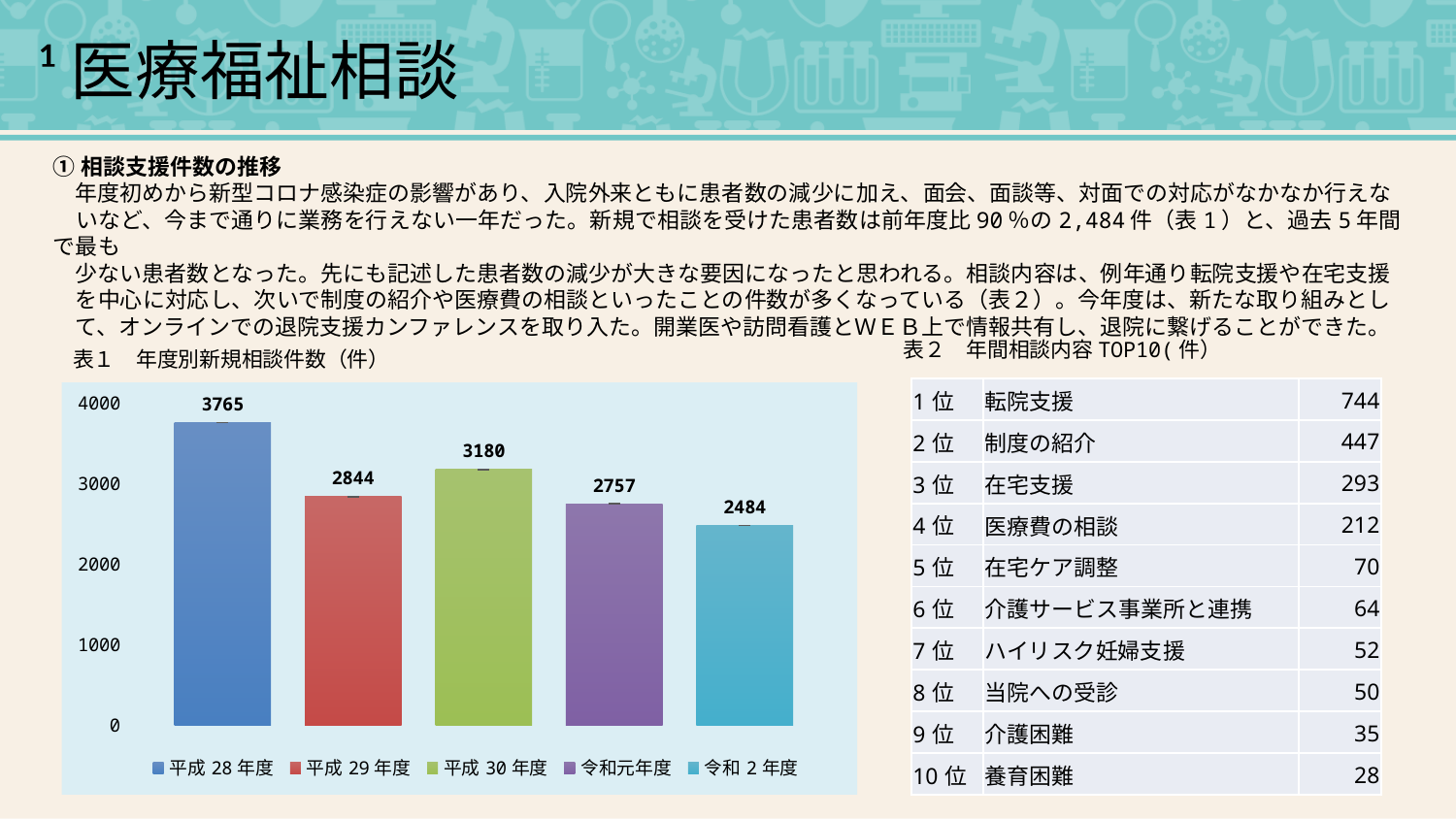
How many entries does the legend of the bar chart list? 5 Is the value for 令和元年度 greater or less than 3000? less What is the value for 令和2年度 in the bar chart? 2484 Which is larger, the value for 平成29年度 or the value for 平成30年度? 平成30年度 What is the value for 平成30年度 in the bar chart? 3180 What is the difference between the values for 平成30年度 and 令和元年度? 423 What is the value for 平成28年度 in the bar chart? 3765 What is the difference between the values for 平成28年度 and 令和2年度? 1281 Which year has the lowest value in the bar chart? 令和2年度 Which year has the highest value in the bar chart? 平成28年度 How many bars are shown in the bar chart? 5 What kind of chart is shown on the slide? bar chart